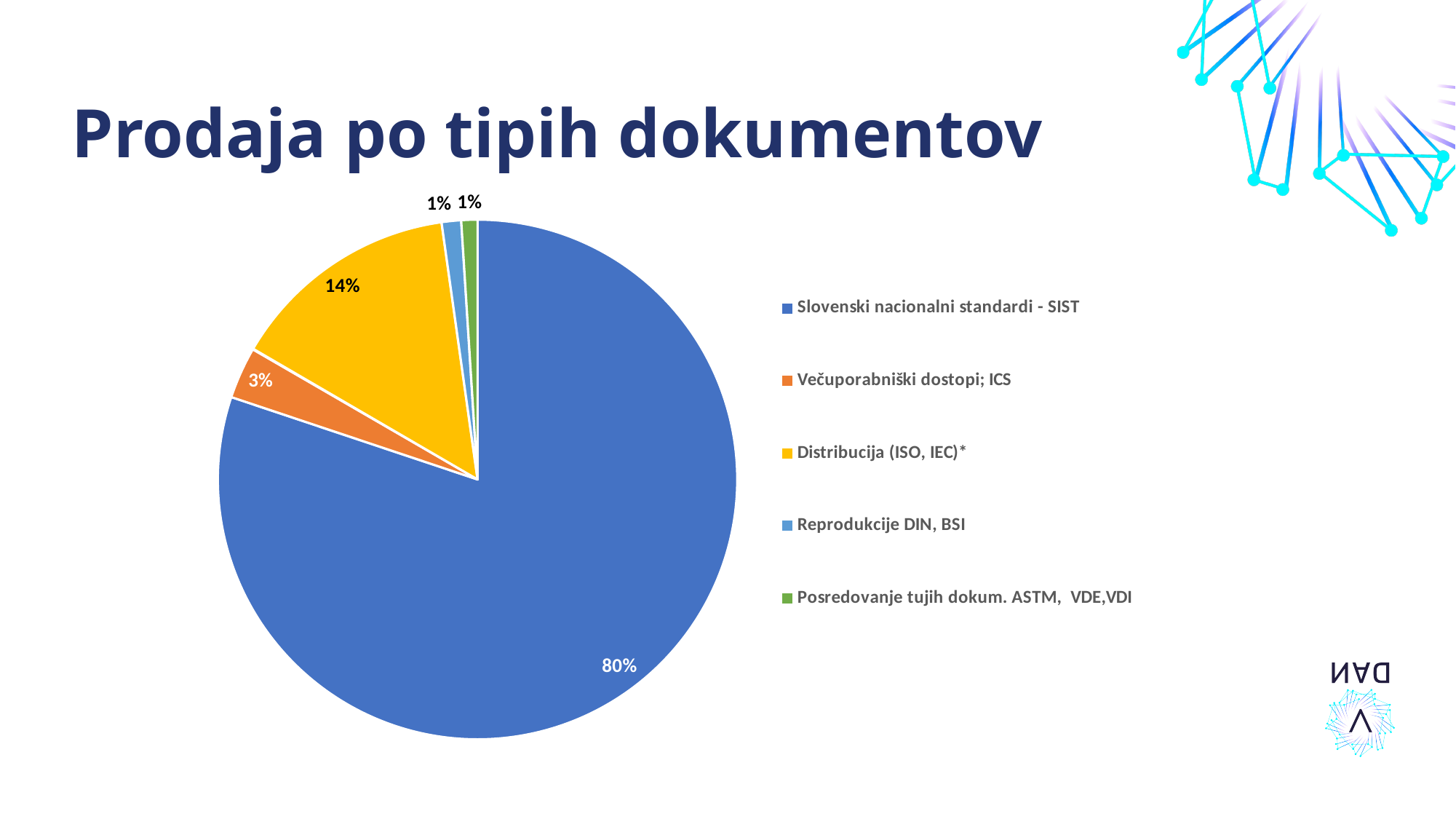
What kind of chart is shown on the slide? pie chart Which category has the largest slice of the pie? Slovenski nacionalni standardi - SIST What colour is the slice for Distribucija (ISO, IEC)*? yellow What is the difference in percentage points between Distribucija (ISO, IEC)* and Večuporabniški dostopi; ICS? 11 Which is larger, the slice for Distribucija (ISO, IEC)* or the slice for Večuporabniški dostopi; ICS? Distribucija (ISO, IEC)* What share of the pie does Slovenski nacionalni standardi - SIST have? 80% What is the difference in percentage points between Slovenski nacionalni standardi - SIST and Distribucija (ISO, IEC)*? 66 What share of the pie does Distribucija (ISO, IEC)* have? 14% What share of the pie does Reprodukcije DIN, BSI have? 1% How many slices does the pie chart have? 5 What is the title of the slide containing the pie chart? Prodaja po tipih dokumentov